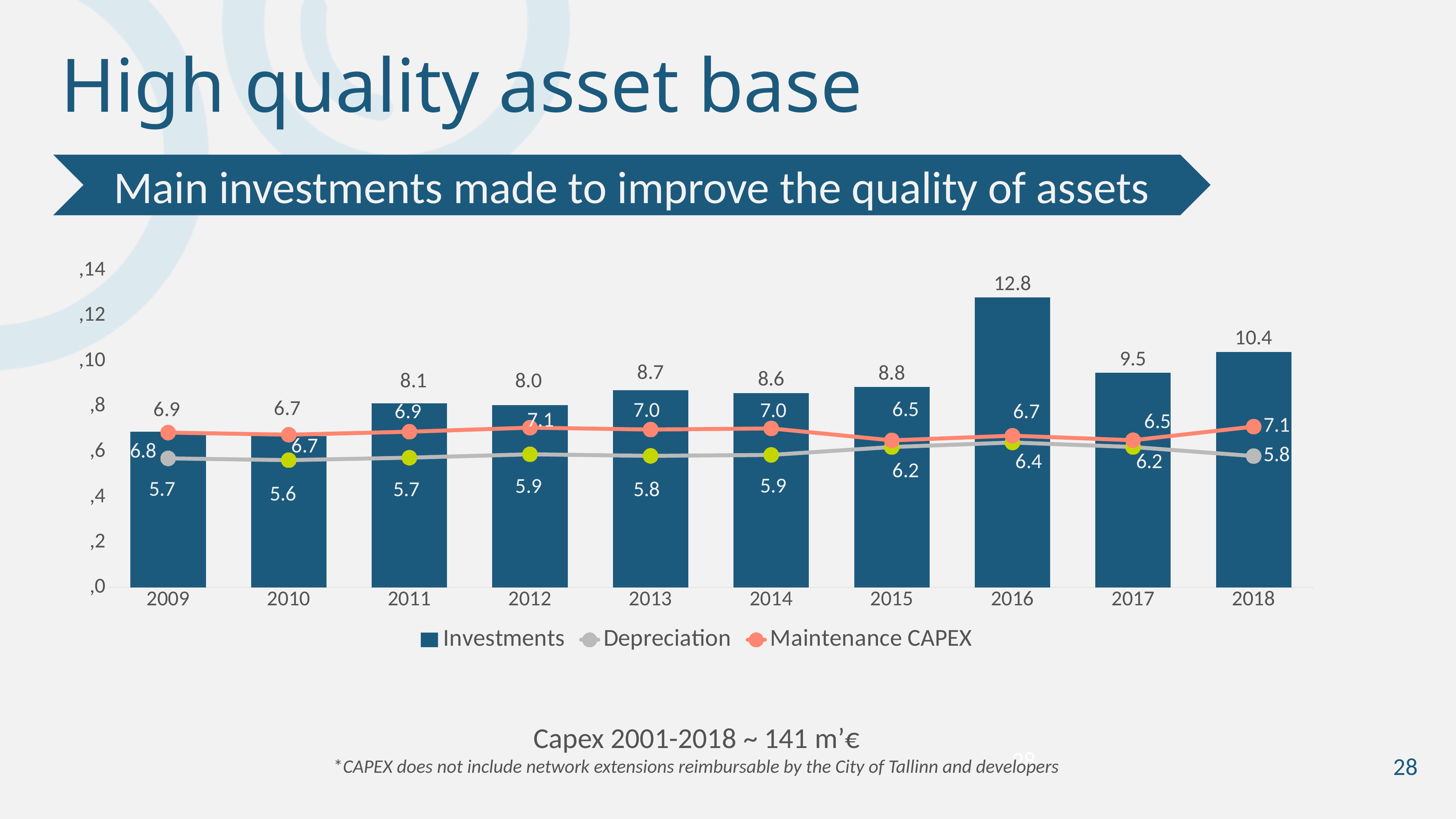
How many years are shown on the x axis? 10 Which is larger in 2018: Investments or Maintenance CAPEX? Investments Which year has the highest Investments value? 2016 What is the Depreciation value for 2015? 6.2 How many series does the legend list? 3 What is the Maintenance CAPEX value for 2012? 7.1 Do the Investments values generally rise or fall from 2009 to 2016? Rise What is the difference between the Investments values for 2016 and 2017? 3.3 Which year has the lowest Depreciation value? 2010 What is the Investments value for 2016? 12.8 Which series is shown with the orange line? Maintenance CAPEX What kind of chart is shown on the slide? Combined bar and line chart